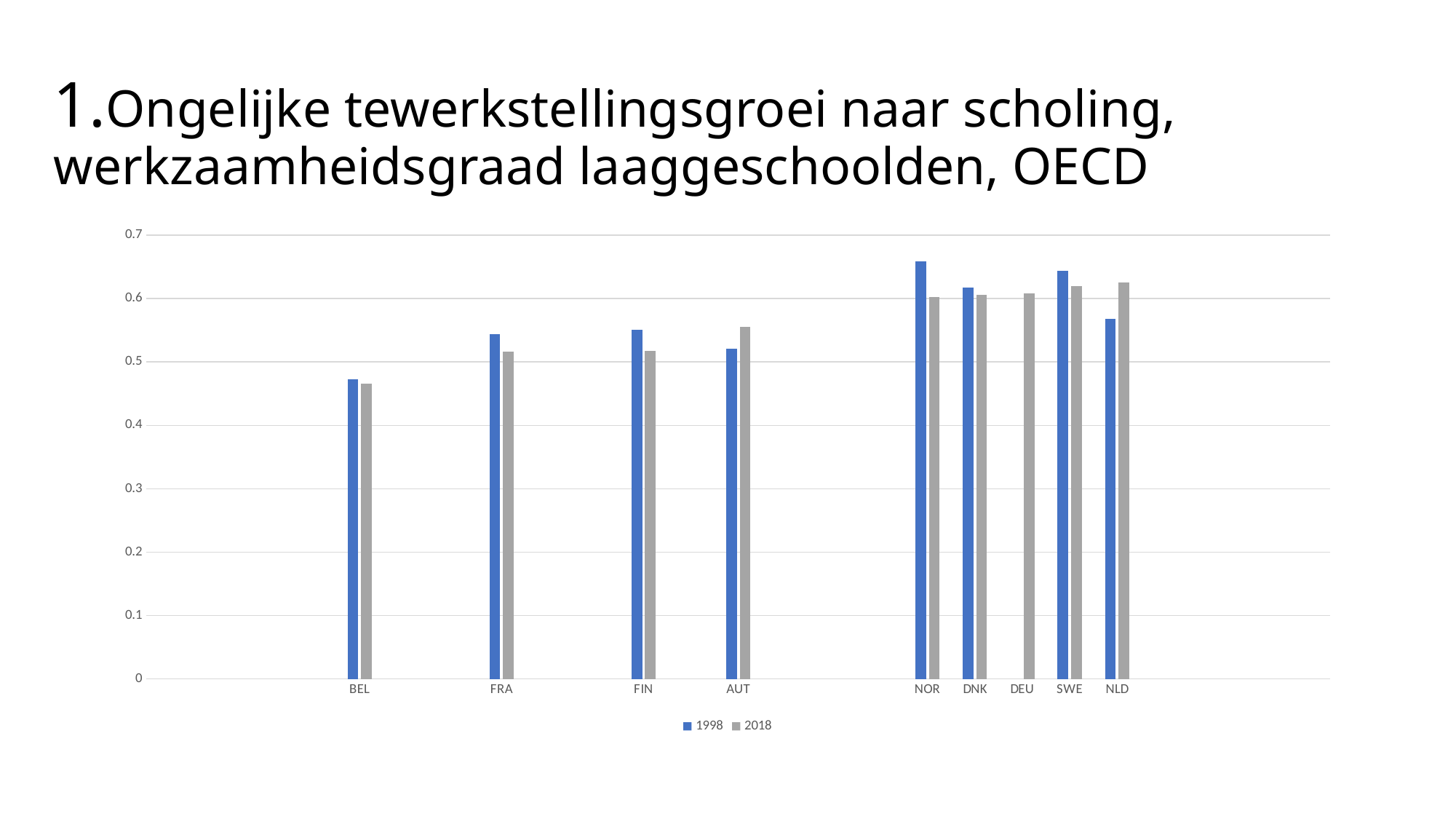
For AUT, which year has the larger value, 1998 or 2018? 2018 For NOR, which year has the larger value, 1998 or 2018? 1998 Which country has the lowest value for 1998? BEL How many series does the legend list? 2 Is the value for NOR in 1998 greater or less than 0.6? greater Which country has the highest value for 1998? NOR How many countries are shown on the x axis? 9 Which country has the lowest value for 2018? BEL Is the value for NLD in 1998 greater or less than 0.6? less What kind of chart is shown on the slide? bar chart Is the value for BEL in 1998 greater or less than 0.5? less Which country has a bar for only one of the two years? DEU